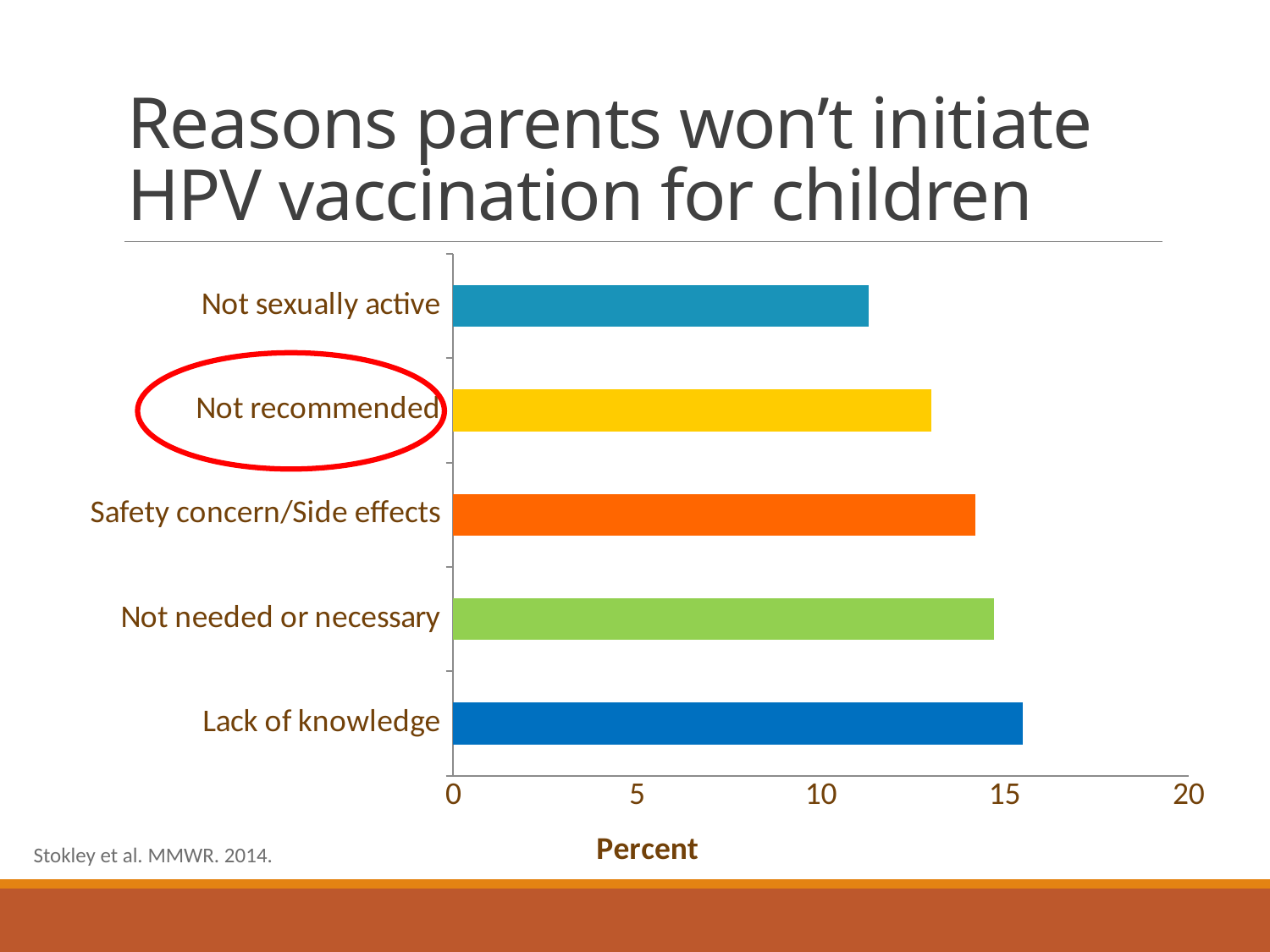
Which is larger, the value for Safety concern/Side effects or the value for Not recommended? Safety concern/Side effects How many reasons (categories) are plotted in the chart? 5 Which reason has the lowest percentage? Not sexually active Is the value for Not sexually active greater or less than 10? greater Which category label is circled in red on the chart? Not recommended Is the value for Not recommended greater or less than 15? less Which reason has the highest percentage? Lack of knowledge What is the title of the horizontal axis? Percent Is the value for Not recommended greater or less than 10? greater What kind of chart is shown on the slide? bar chart Which is larger, the value for Lack of knowledge or the value for Not sexually active? Lack of knowledge